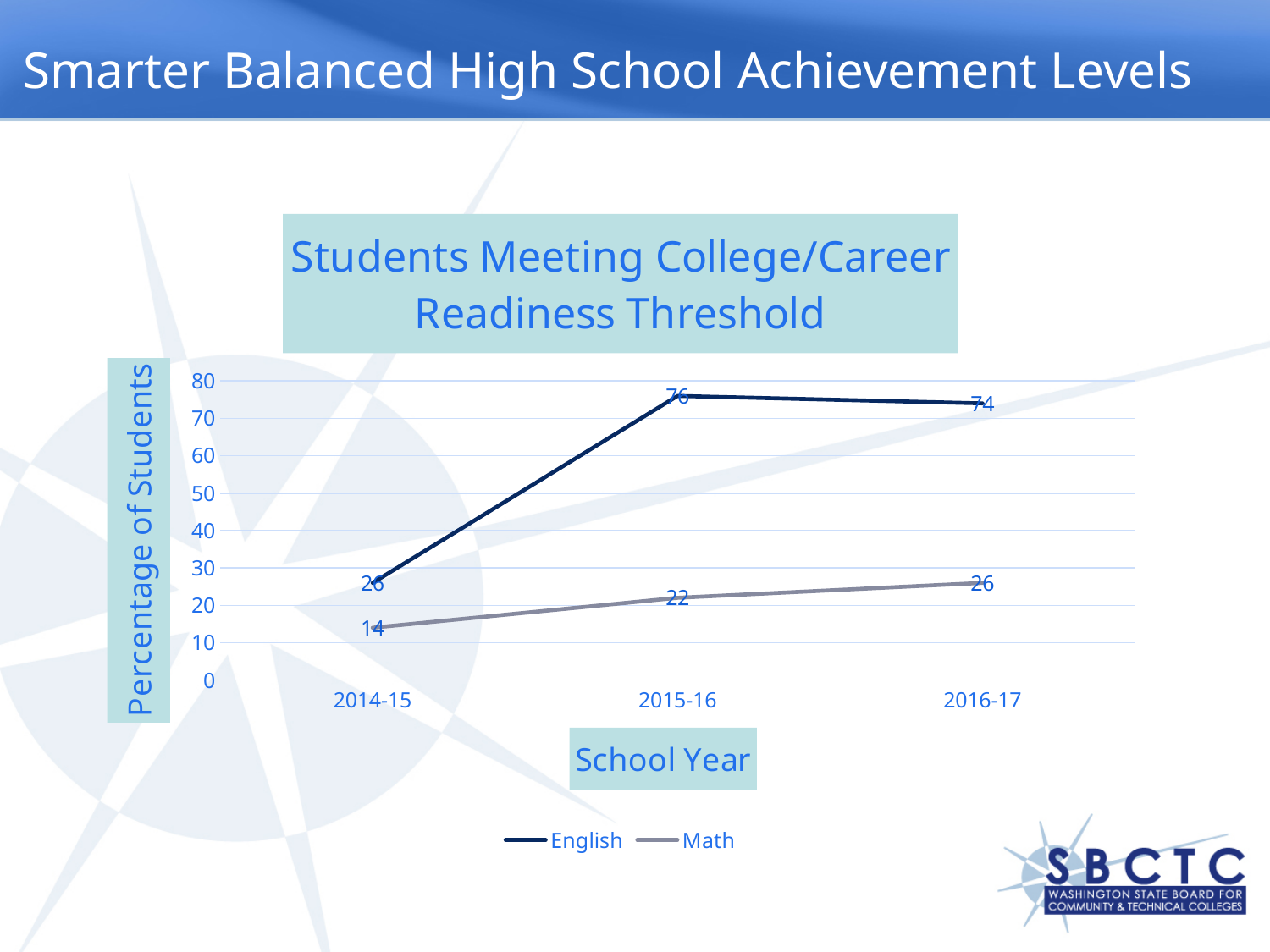
In which school year is the English value highest? 2015-16 How many series does the legend list? 2 What is the Math value for 2014-15? 14 Does the Math series rise or fall from 2014-15 to 2016-17? Rise What kind of chart is this? Line chart Which is larger in 2014-15, the English value or the Math value? English What is the difference between the English and Math values in 2015-16? 54 How many school years are shown on the x axis? 3 What is the English value for 2016-17? 74 What is the Math value for 2016-17? 26 In which school year is the Math value lowest? 2014-15 What is the English value for 2015-16? 76